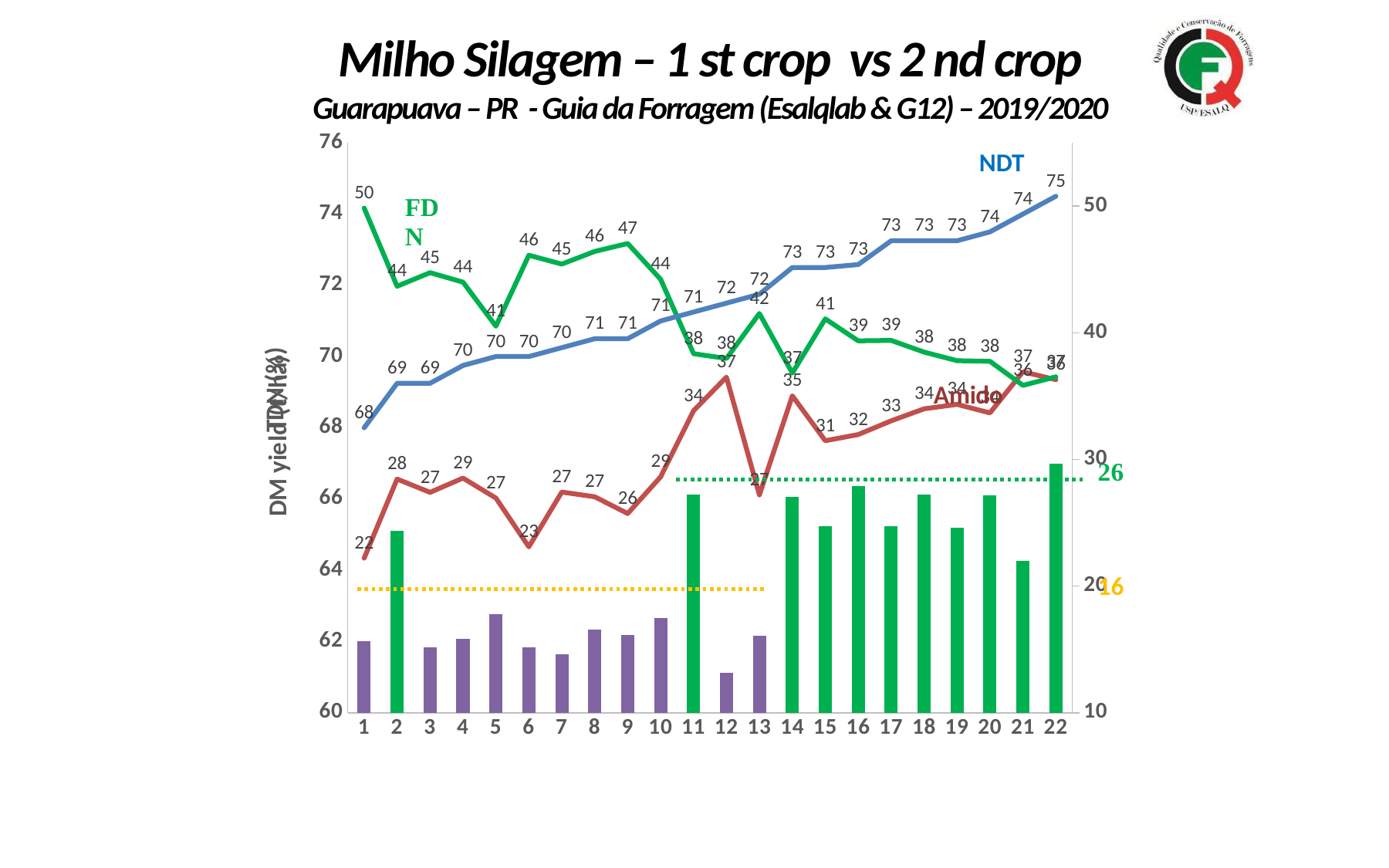
Does the NDT line rise or fall from category 1 to category 22? Rises How many categories are shown on the x axis? 22 Which category has the lowest Amido value? 1 What kind of chart is shown on the slide? A combined bar and line chart Which is larger, the FDN value at category 9 or at category 11? Category 9 Is the bar for category 12 greater or less than 20 on the right axis? less Which category has the highest NDT value? 22 What is the Amido value for category 12? 37 What is the difference between the NDT value at category 22 and at category 1? 7 Which category has the lowest FDN value? 21 What is the NDT value for category 1? 68 What is the FDN value for category 1? 50